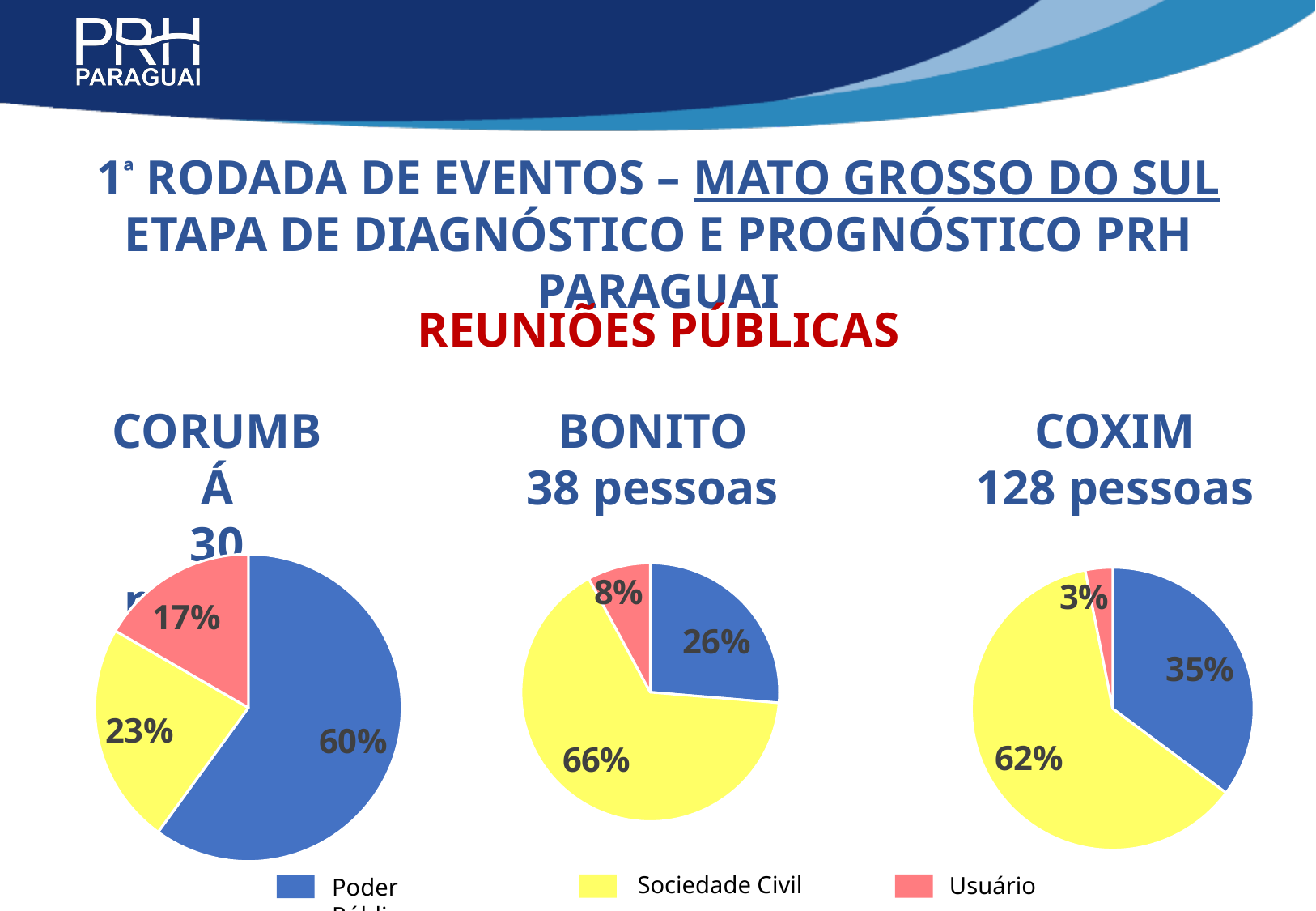
In the CORUMBÁ pie chart, which category has the largest share? Poder Público (blue) In the CORUMBÁ pie chart, what share is Usuário (red)? 17% In the COXIM pie chart, which category has the smallest share? Usuário In the CORUMBÁ pie chart, what share is Sociedade Civil (yellow)? 23% How many slices does the BONITO pie chart have? 3 In the BONITO pie chart, what share is Usuário (red)? 8% Which is larger: the Sociedade Civil share in BONITO or the Sociedade Civil share in COXIM? BONITO What type of chart is used for CORUMBÁ, BONITO and COXIM? Pie chart In the BONITO pie chart, what is the difference between the Sociedade Civil share and the blue (Poder Público) share? 40 percentage points